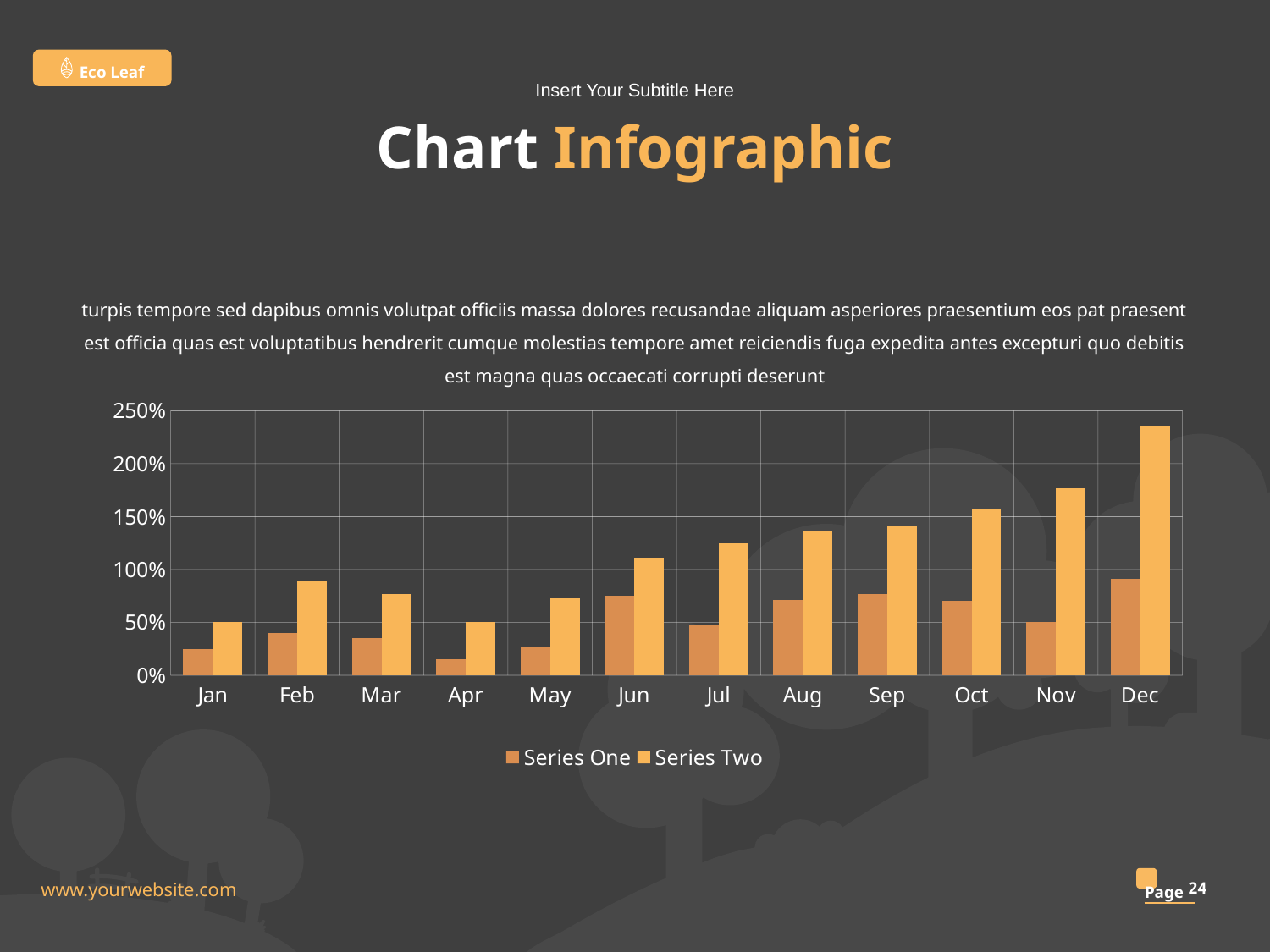
Which is larger, the Series One value for Jun or the Series One value for Jul? Jun Is the Series Two value for Nov greater or less than 150%? greater Is the Series Two value for Feb greater or less than 100%? less Is the Series Two value for Dec greater or less than 200%? greater How many categories are shown on the x axis of the chart? 12 In which month is the Series Two value highest? Dec Do the Series Two values generally rise or fall from Jan to Dec? rise What kind of chart is shown on the slide? bar chart What are the names of the two series in the legend? Series One and Series Two How many series does the chart's legend list? 2 In which month is the Series One value lowest? Apr